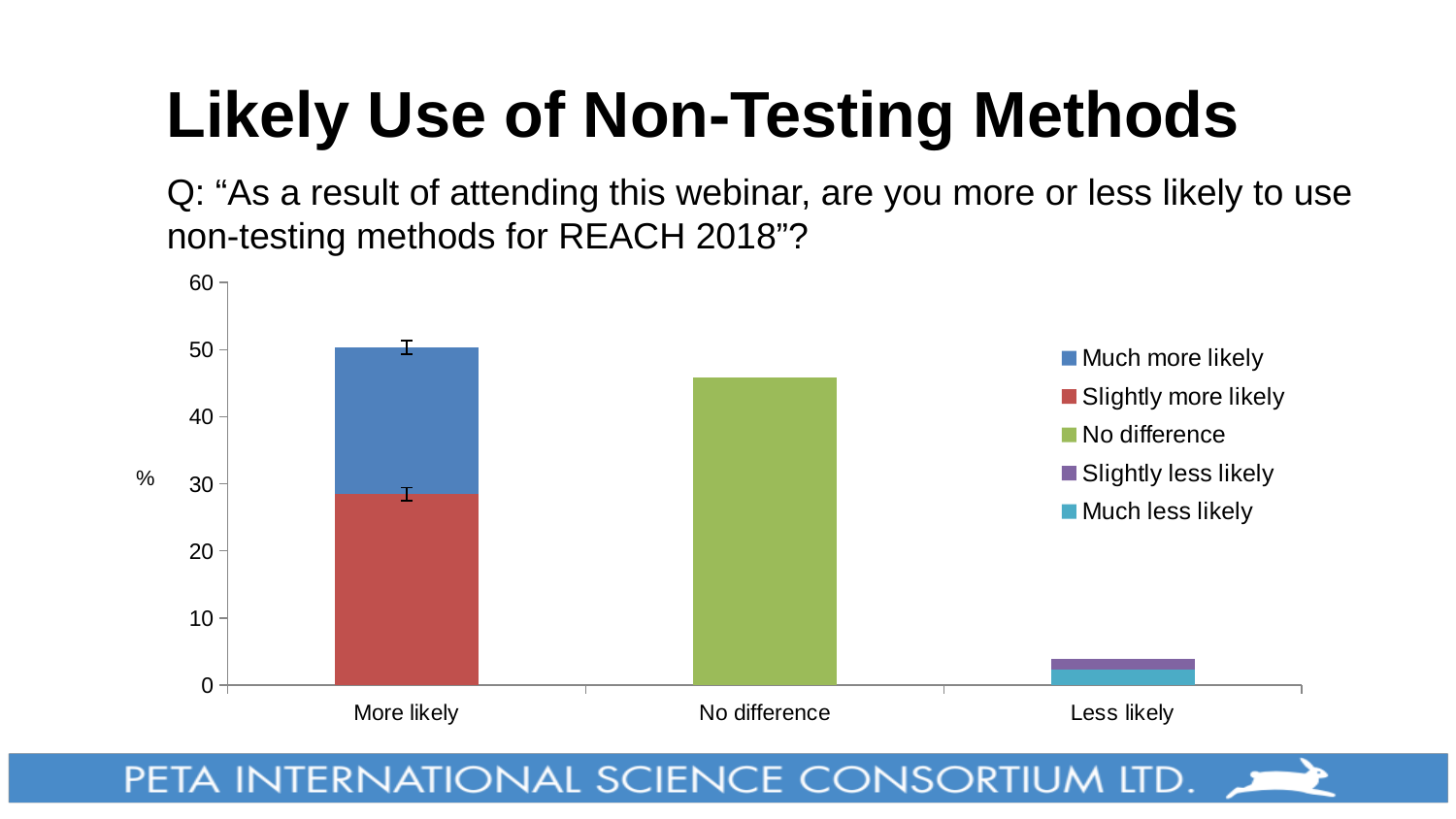
How many categories are shown on the x axis of the chart? 3 Is the total value for More likely greater or less than 40? greater Which category has the tallest bar in the chart? More likely What is the label on the y axis of the chart? % Is the Slightly more likely segment of the More likely bar greater or less than 20? greater Is the value for No difference greater or less than 40? greater Which category has the shortest bar in the chart? Less likely How many series does the chart's legend list? 5 Which bar is taller, More likely or No difference? More likely What kind of chart is shown on the slide? Bar chart Which legend entry is shown in green? No difference